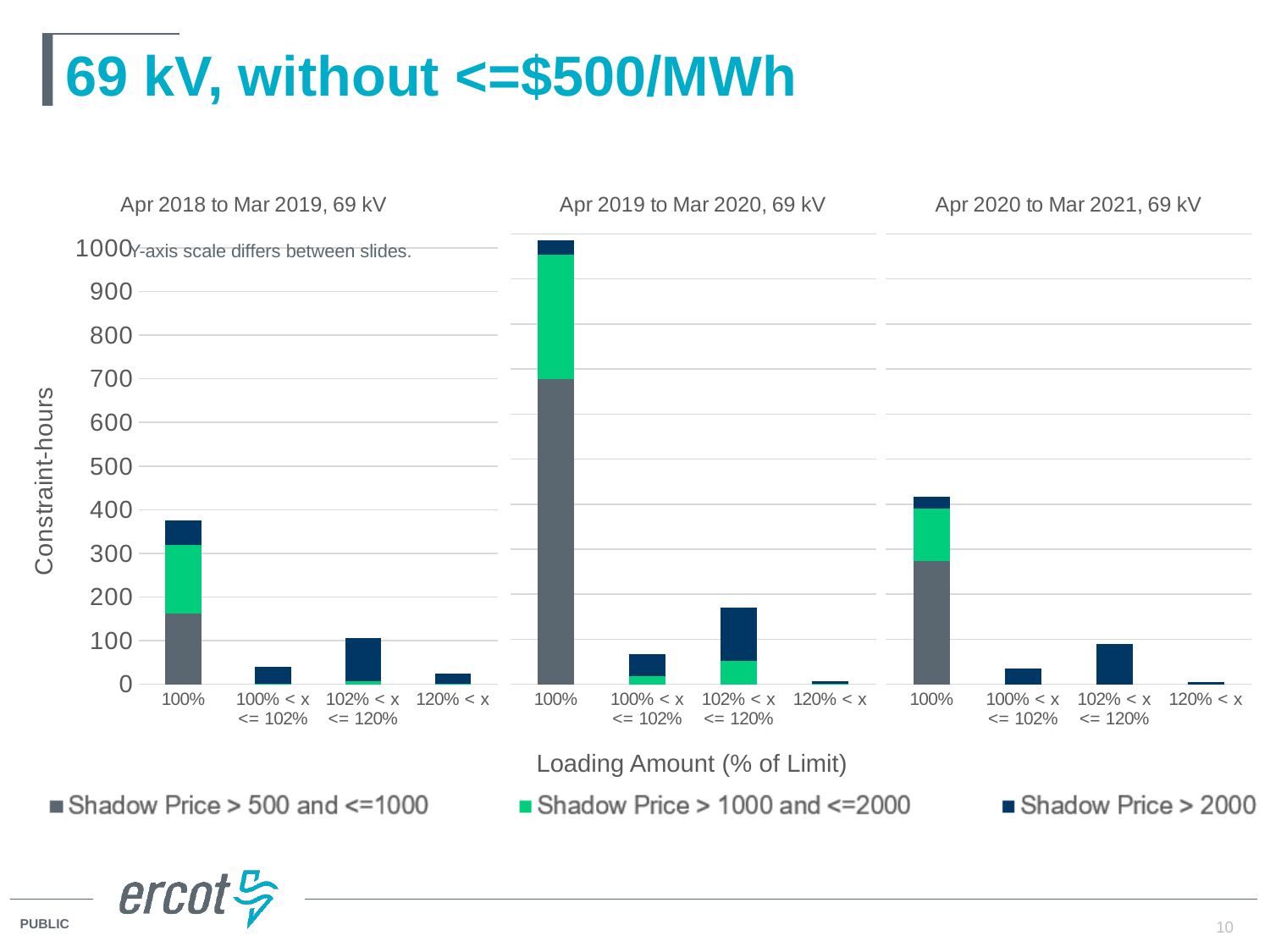
In the chart titled 'Apr 2018 to Mar 2019, 69 kV', is the total constraint-hours for the 100% category greater or less than 300? greater In the chart titled 'Apr 2018 to Mar 2019, 69 kV', which loading amount category has the tallest stacked bar? 100% In the chart titled 'Apr 2018 to Mar 2019, 69 kV', which loading amount category has the shortest stacked bar? 120% < x What is the title of the y-axis shared by the charts? Constraint-hours In the chart titled 'Apr 2019 to Mar 2020, 69 kV', is the total constraint-hours for the 100% category greater or less than 900? greater In the chart titled 'Apr 2020 to Mar 2021, 69 kV', is the total constraint-hours for the 100% category greater or less than 500? less What kind of chart is shown on the slide? Stacked bar chart Which chart has the taller stacked bar for the 100% category: 'Apr 2018 to Mar 2019, 69 kV' or 'Apr 2019 to Mar 2020, 69 kV'? Apr 2019 to Mar 2020, 69 kV In the chart titled 'Apr 2019 to Mar 2020, 69 kV', which has the taller stacked bar: '100% < x <= 102%' or '102% < x <= 120%'? 102% < x <= 120% How many series does the legend list? 3 In the chart titled 'Apr 2018 to Mar 2019, 69 kV', how many loading amount categories are plotted? 4